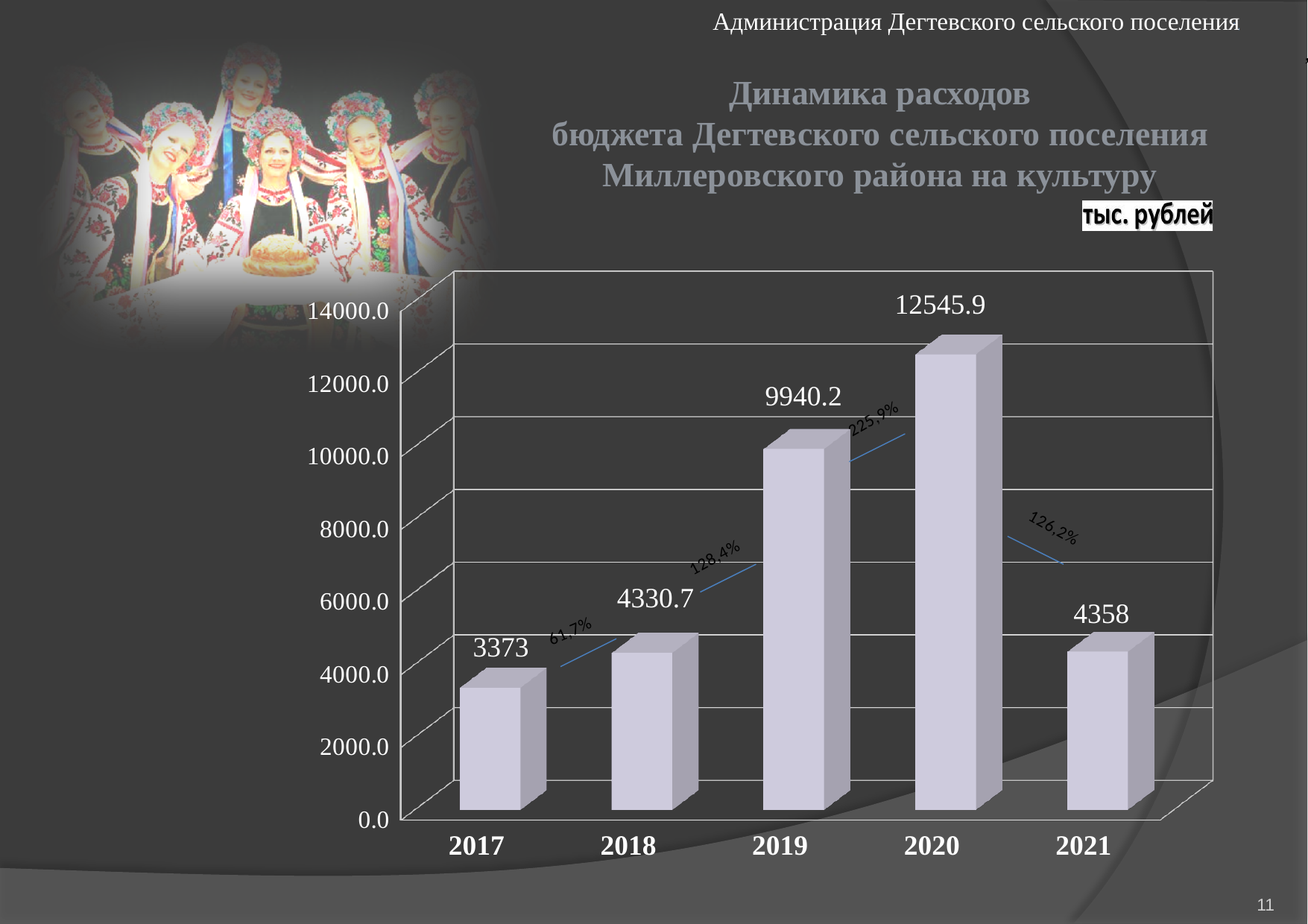
What is the difference between the values for 2021 and 2017? 985 What kind of chart is shown on the slide? bar chart What is the value for 2021? 4358 How many years are shown on the x axis? 5 What is the value for 2019? 9940.2 Which year has the highest value? 2020 What is the value for 2017? 3373 Which year has the lowest value? 2017 What is the difference between the values for 2020 and 2019? 2605.7 Is the value for 2020 greater or less than 12000.0? greater Which is larger, the value for 2018 or the value for 2021? 2021 What unit is indicated for the chart values? тыс. рублей